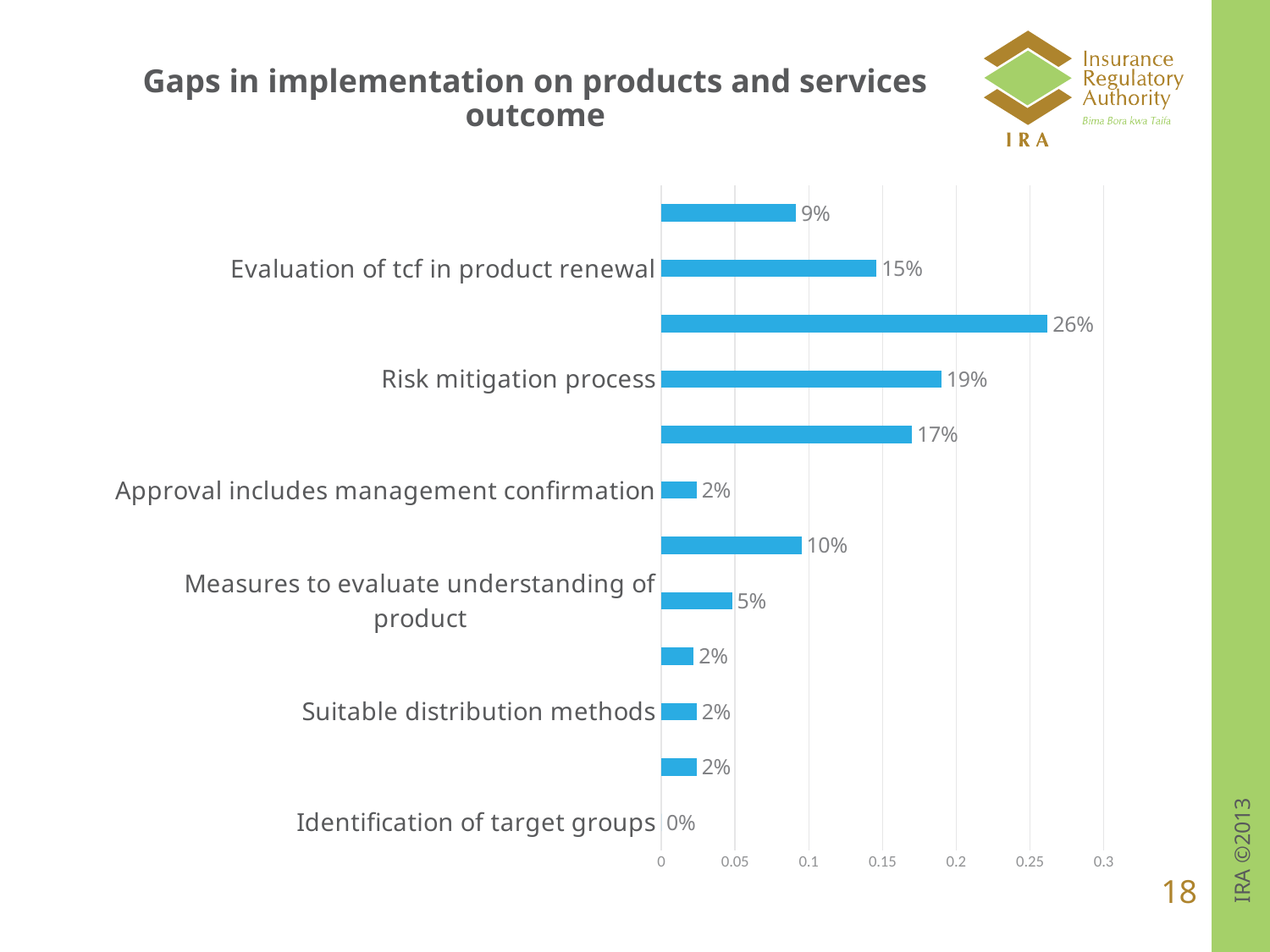
How many bars are plotted in the chart? 12 What is the value for Identification of target groups? 0% What kind of chart is shown on the slide? Bar chart What is the value for Evaluation of tcf in product renewal? 15% What is the value for Measures to evaluate understanding of product? 5% What is the value for Risk mitigation process? 19% What is the title of the slide containing the chart? Gaps in implementation on products and services outcome Which labelled category has the lowest value? Identification of target groups What is the value for Approval includes management confirmation? 2% What is the largest value labelled on any bar in the chart? 26% Which is larger, the value for Measures to evaluate understanding of product or the value for Suitable distribution methods? Measures to evaluate understanding of product What is the difference between the values for Risk mitigation process and Evaluation of tcf in product renewal? 4%